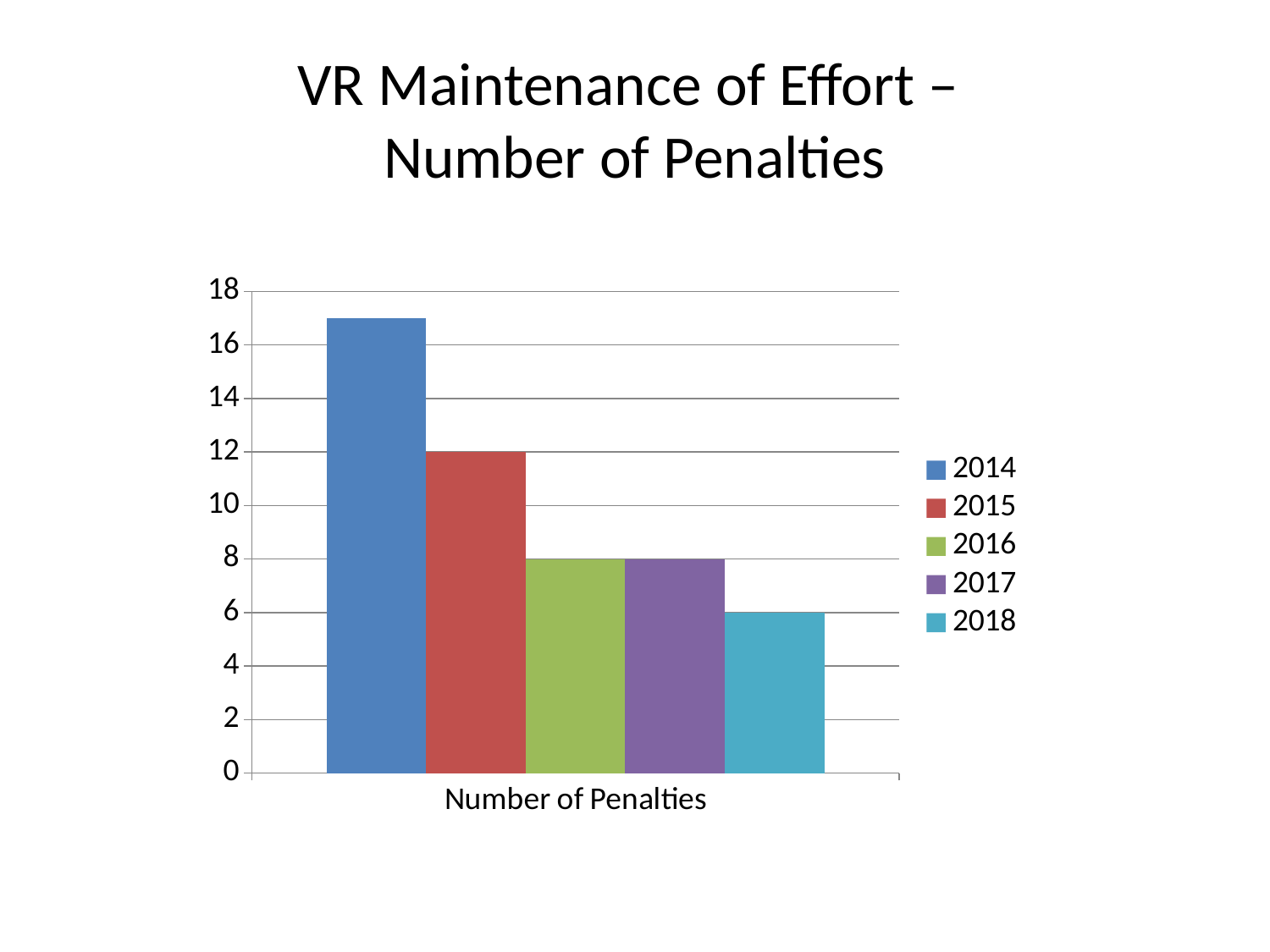
What is the value for 2015? 12 Do the values rise or fall from 2014 to 2018? fall What is the title of the slide? VR Maintenance of Effort – Number of Penalties What is the value for 2018? 6 What is the value for 2016? 8 Which year has the highest number of penalties? 2014 What kind of chart is shown on the slide? bar chart Which year has the lowest number of penalties? 2018 Is the value for 2014 greater or less than 16? greater What is the difference between the values for 2015 and 2018? 6 Which is larger, the value for 2015 or the value for 2018? 2015 How many series does the legend list? 5